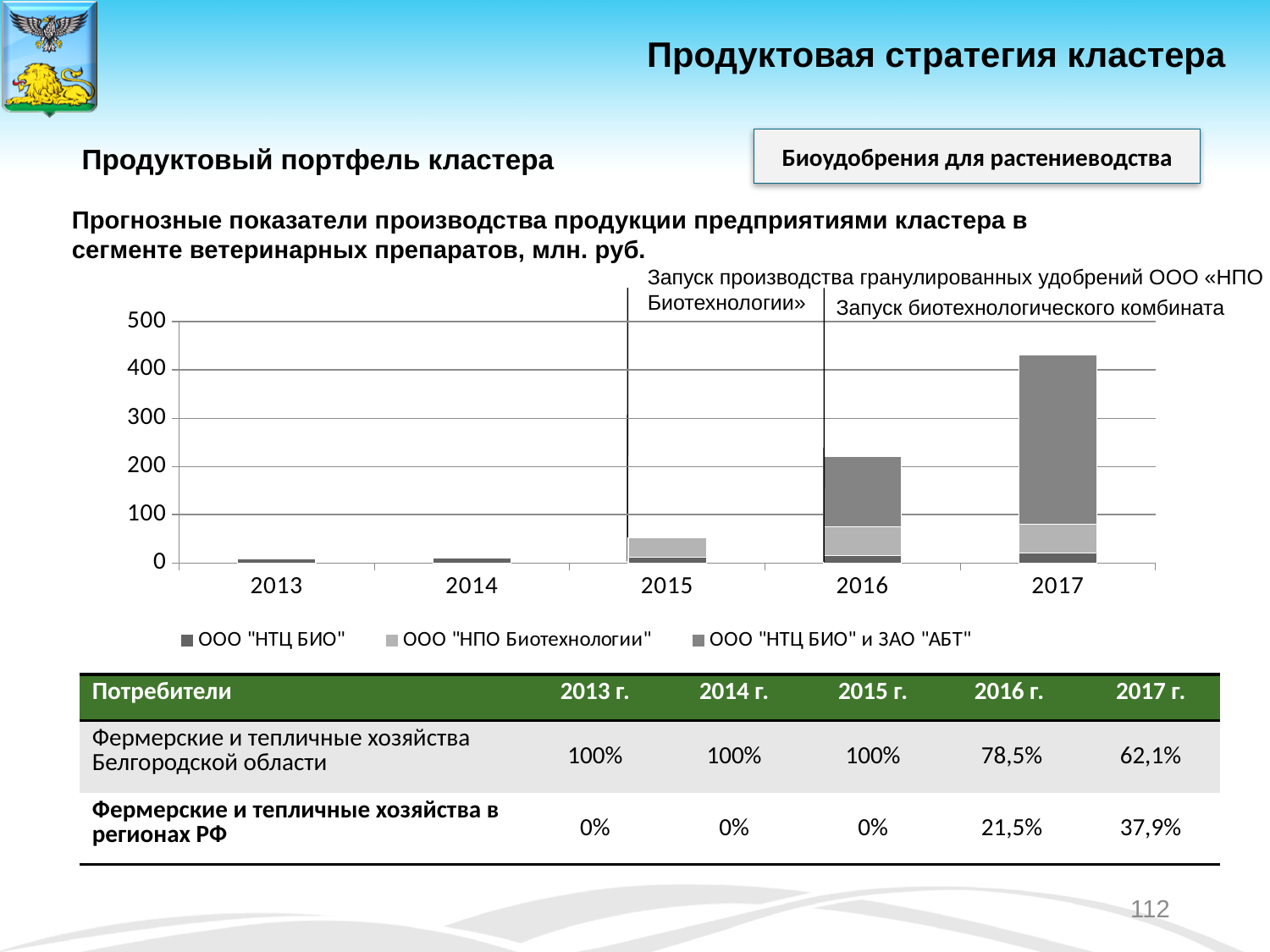
How many years are shown on the x axis of the chart? 5 Which year has the highest total bar in the chart? 2017 Is the total value for 2014 greater or less than 100? less Is the total value for 2017 greater or less than 400? greater In what units are the values in the chart expressed, according to the heading above it? млн. руб. Which series is listed first in the chart legend? ООО "НТЦ БИО" Is the total value for 2015 greater or less than 100? less What kind of chart is shown on the slide? Stacked bar chart How many series does the chart legend list? 3 Which year has the larger total bar, 2016 or 2017? 2017 Do the total bar values rise or fall from 2013 to 2017? rise